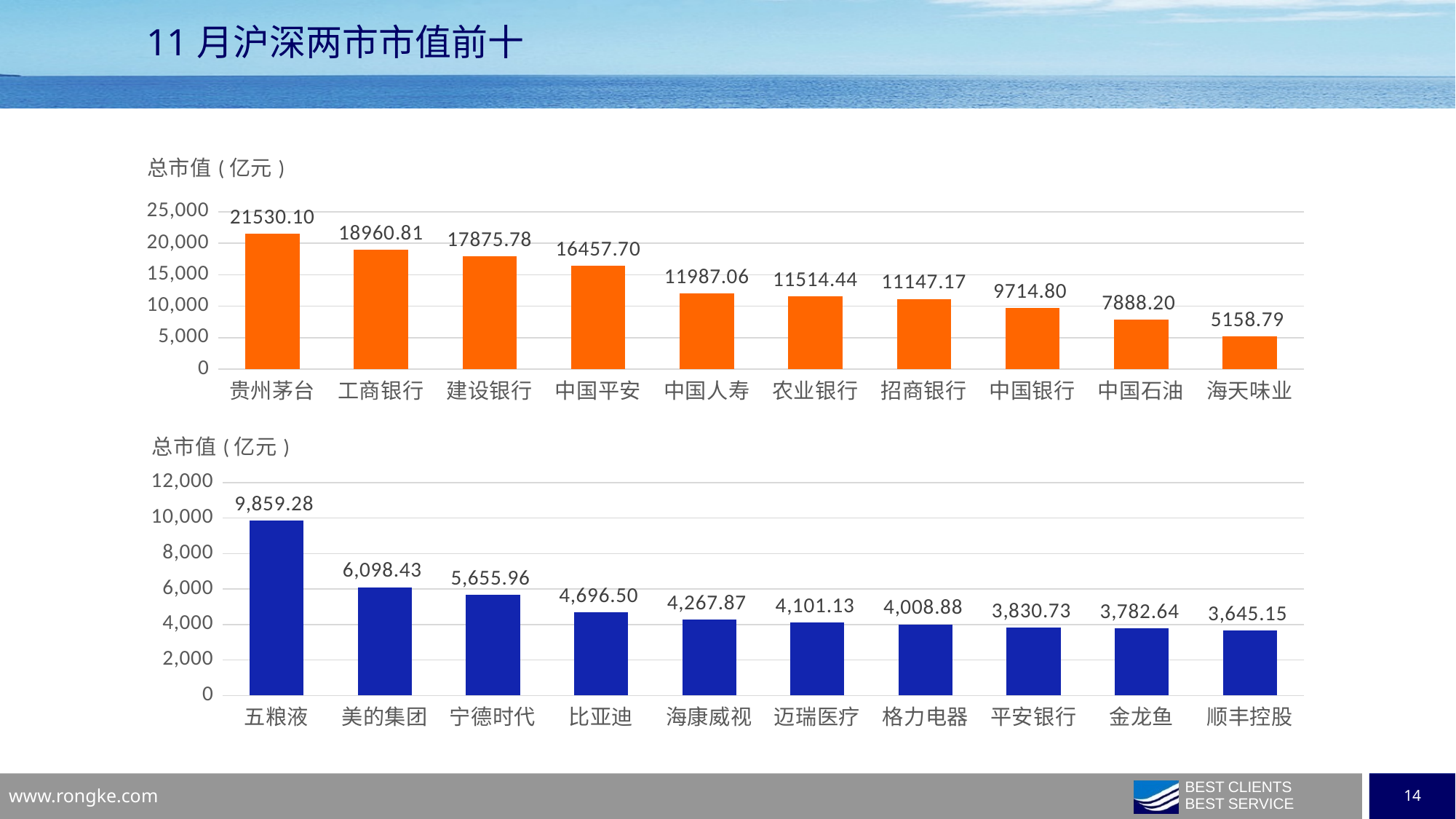
In the top chart, what is the difference between the values for 贵州茅台 and 工商银行? 2569.29 In the top chart, which is larger, the value for 中国人寿 or the value for 招商银行? 中国人寿 In the bottom chart, what is the difference between the values for 五粮液 and 美的集团? 3,760.85 In the top chart, what is the value for 贵州茅台? 21530.10 In the top chart, which category has the lowest value? 海天味业 What colour are the bars in the bottom chart? blue In the bottom chart, what is the value for 顺丰控股? 3,645.15 What kind of chart is the top chart? bar chart In the bottom chart, which category has the highest value? 五粮液 How many categories are shown in the bottom chart? 10 In the bottom chart, what is the value for 宁德时代? 5,655.96 In the top chart, what is the value for 中国石油? 7888.20